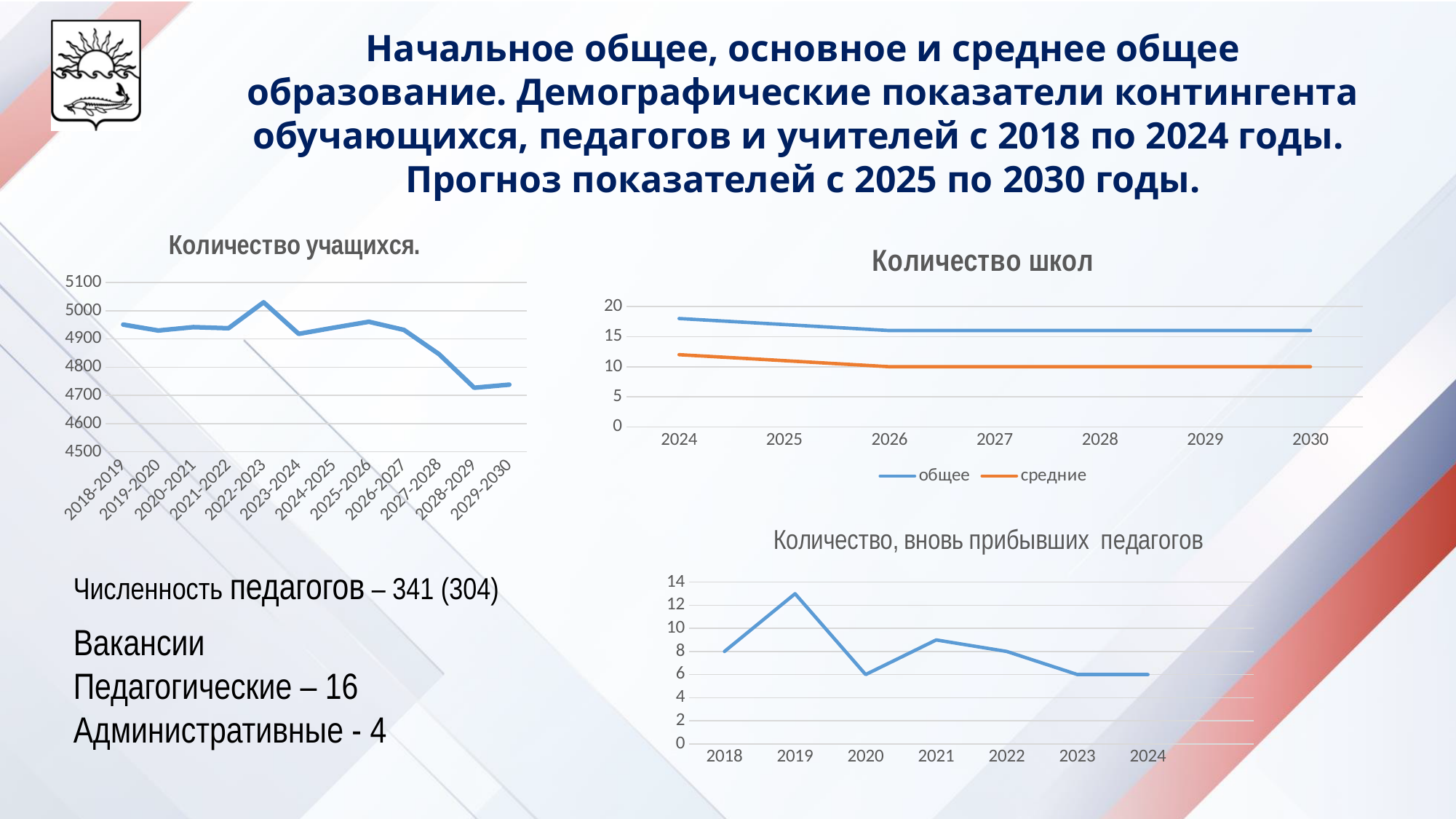
How many series does the legend of the "Количество школ" chart list? 2 How many school years are shown on the x axis of the "Количество учащихся." chart? 12 In the "Количество школ" chart, which series is higher in 2030, "общее" or "средние"? общее In the "Количество школ" chart, what is the value of "средние" in 2030? 10 What type of chart is the "Количество учащихся." chart? line chart In the "Количество, вновь прибывших педагогов" chart, what is the value for 2024? 6 In the "Количество учащихся." chart, which school year has the highest number of students? 2022-2023 In the "Количество, вновь прибывших педагогов" chart, which year has the highest value? 2019 In the "Количество школ" chart, is the value of "общее" in 2024 greater or less than 15? greater In the "Количество, вновь прибывших педагогов" chart, what is the value for 2018? 8 In the "Количество учащихся." chart, is the value for 2022-2023 greater or less than 5000? greater In the "Количество учащихся." chart, is the value for 2028-2029 greater or less than 4800? less